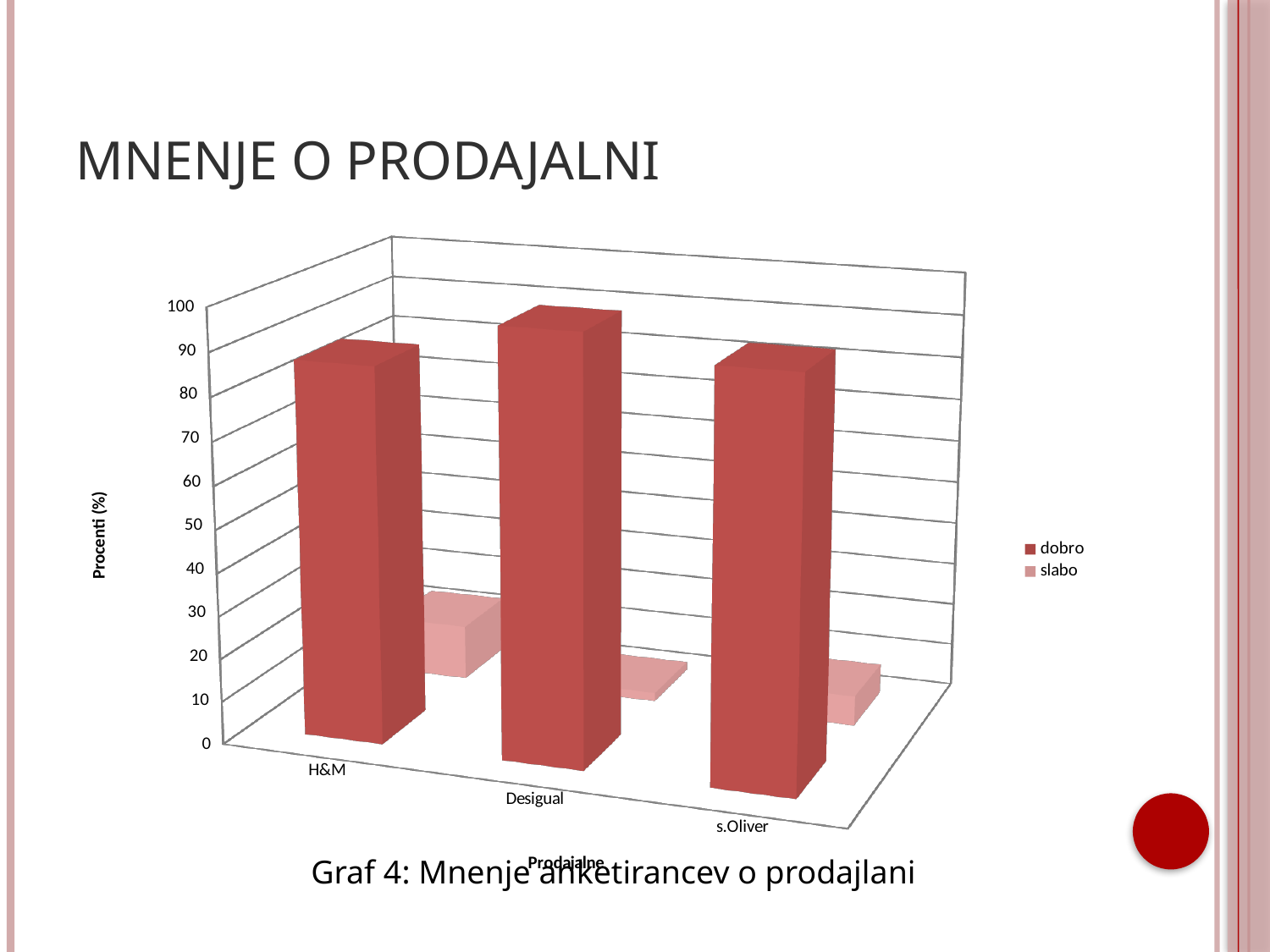
Is the value for dobro at s.Oliver greater or less than 60? greater For Desigual, which series has the larger value, dobro or slabo? dobro Is the value for slabo at s.Oliver greater or less than 40? less How many series does the chart's legend list? 2 For H&M, which series has the larger value, dobro or slabo? dobro What kind of chart is shown on the slide? bar chart What is the title of the vertical axis of the chart? Procenti (%) Is the value for slabo at H&M greater or less than 50? less What are the two series named in the chart's legend? dobro, slabo How many stores (categories) are shown on the x axis of the chart? 3